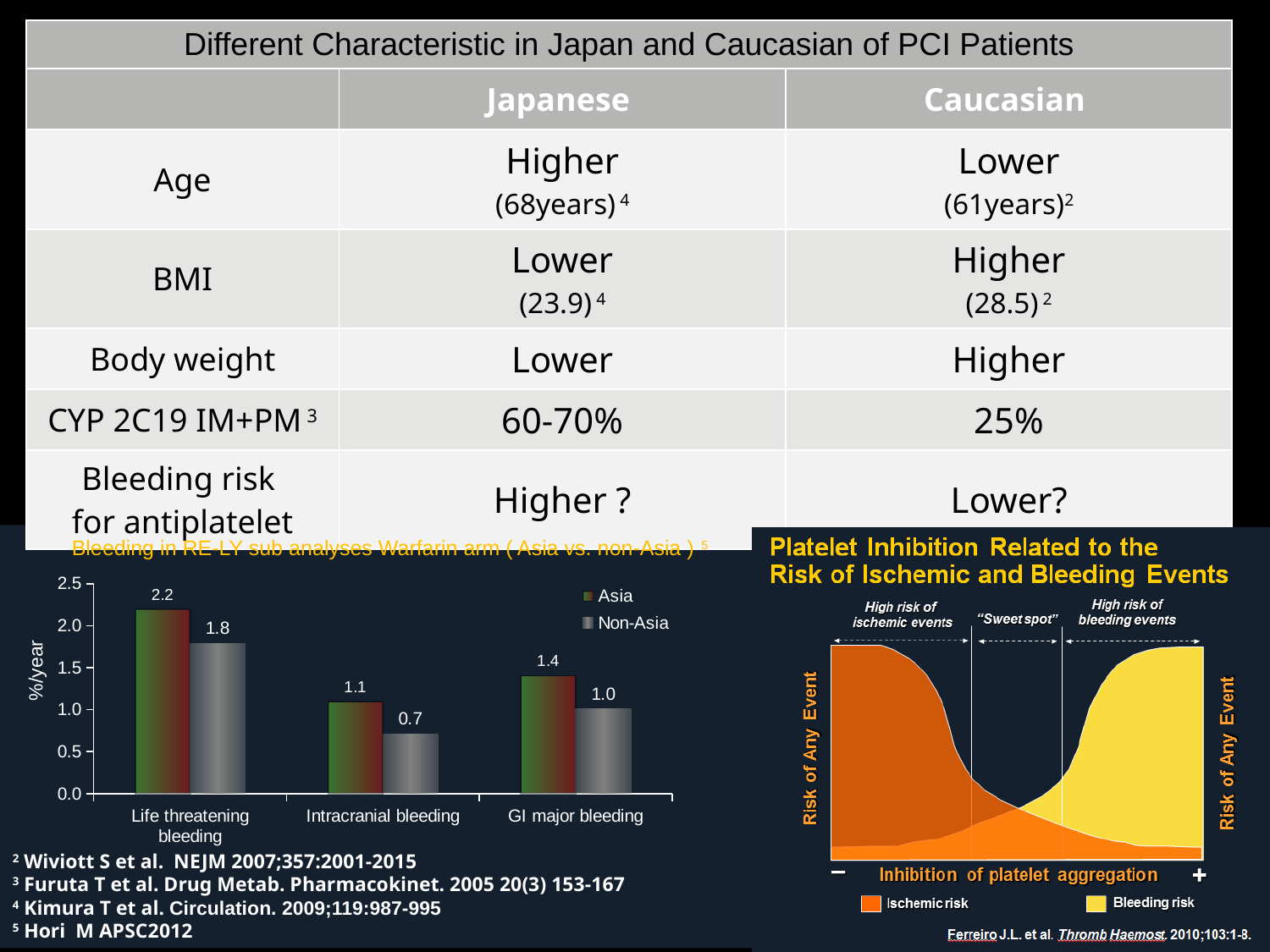
What kind of chart is shown at the bottom left of the slide? Bar chart In the bar chart at the bottom left, what is the Non-Asia value for GI major bleeding? 1.0 In the bar chart at the bottom left, which category has the highest Asia value? Life threatening bleeding What is the y-axis label of the bar chart at the bottom left? %/year In the bar chart at the bottom left, which is larger for Intracranial bleeding, the Asia value or the Non-Asia value? Asia In the bar chart at the bottom left, what is the difference between the Asia and Non-Asia values for Life threatening bleeding? 0.4 In the bar chart at the bottom left, which category has the lowest Non-Asia value? Intracranial bleeding How many categories are shown on the x axis of the bar chart at the bottom left? 3 In the bar chart at the bottom left, what is the Asia value for Life threatening bleeding? 2.2 In the bar chart at the bottom left, what is the Non-Asia value for Intracranial bleeding? 0.7 How many series does the legend of the bar chart at the bottom left list? 2 In the bar chart at the bottom left, what is the difference between the Asia and Non-Asia values for GI major bleeding? 0.4